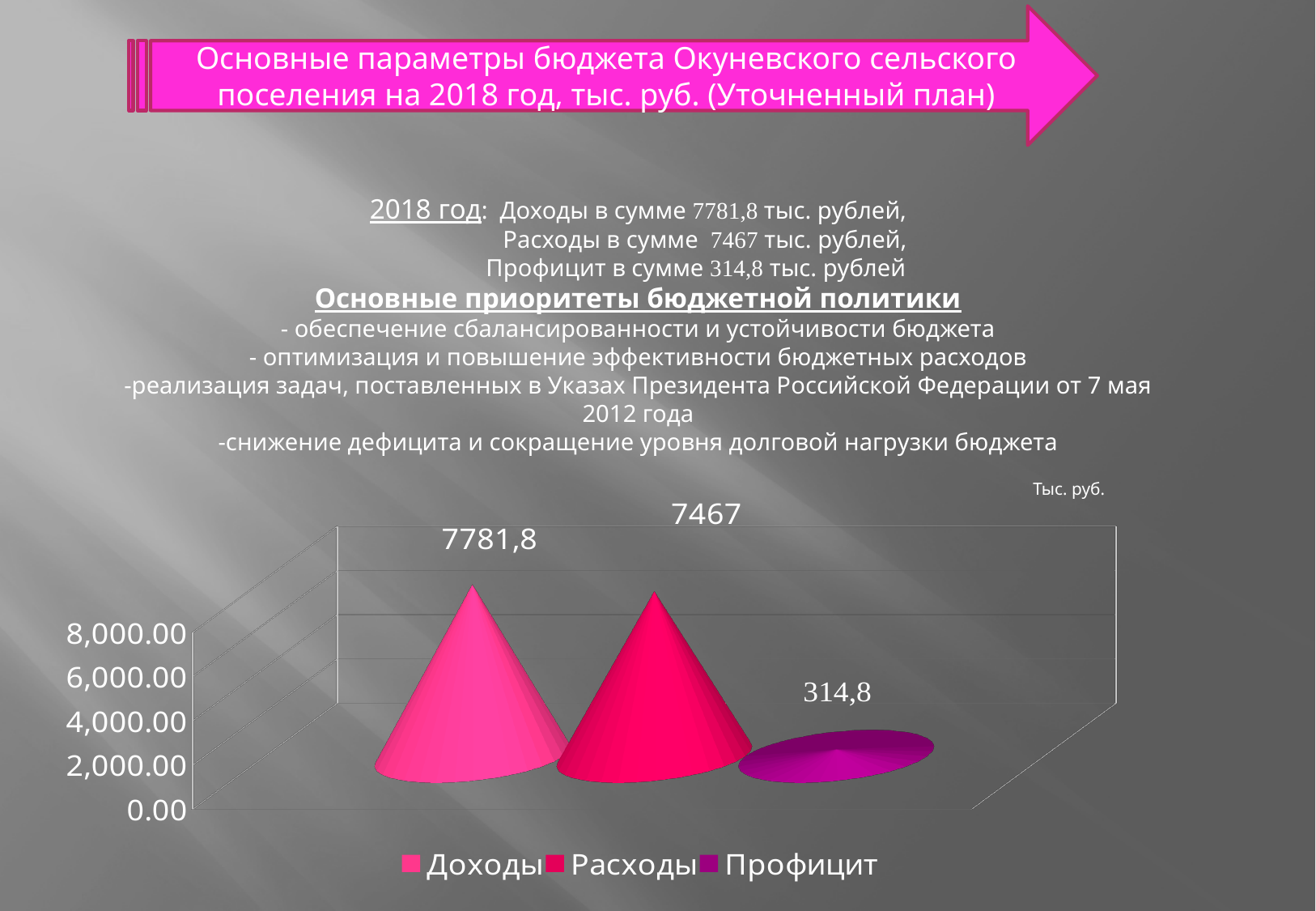
What is the difference between the values for Доходы and Расходы? 314,8 How many series does the legend list? 3 Which is larger, the value for Доходы or the value for Расходы? Доходы What is the difference between the values for Расходы and Профицит? 7152,2 What kind of chart is shown on the slide? bar chart What is the value shown for Доходы on the chart? 7781,8 What is the value shown for Расходы on the chart? 7467 What is the value shown for Профицит on the chart? 314,8 Which series has the lowest value on the chart? Профицит Which series has the highest value on the chart? Доходы Is the value for Профицит greater or less than 2,000.00? less What unit label is shown above the chart? Тыс. руб.